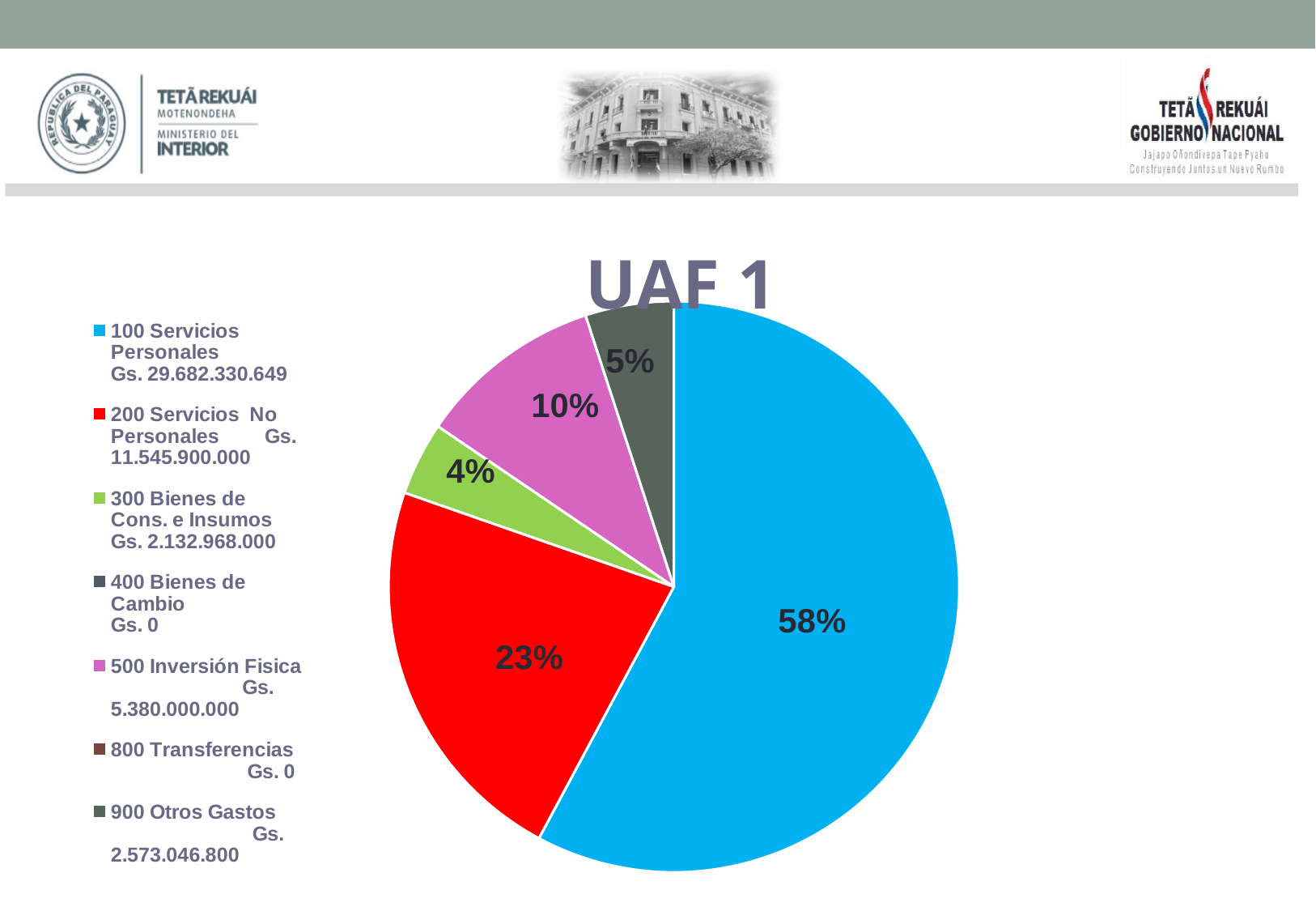
What amount in Gs. is shown in the legend for 200 Servicios No Personales? Gs. 11.545.900.000 Which is larger, the share for 500 Inversión Fisica or the share for 900 Otros Gastos? 500 Inversión Fisica What percentage share does the 200 Servicios No Personales slice have? 23% How many entries does the legend list? 7 What kind of chart is shown on the slide? pie chart What percentage share does the 300 Bienes de Cons. e Insumos slice have? 4% What percentage share does the 100 Servicios Personales slice have? 58% What is the title of the pie chart? UAF 1 Which category has the largest slice of the pie? 100 Servicios Personales What amount in Gs. is shown in the legend for 900 Otros Gastos? Gs. 2.573.046.800